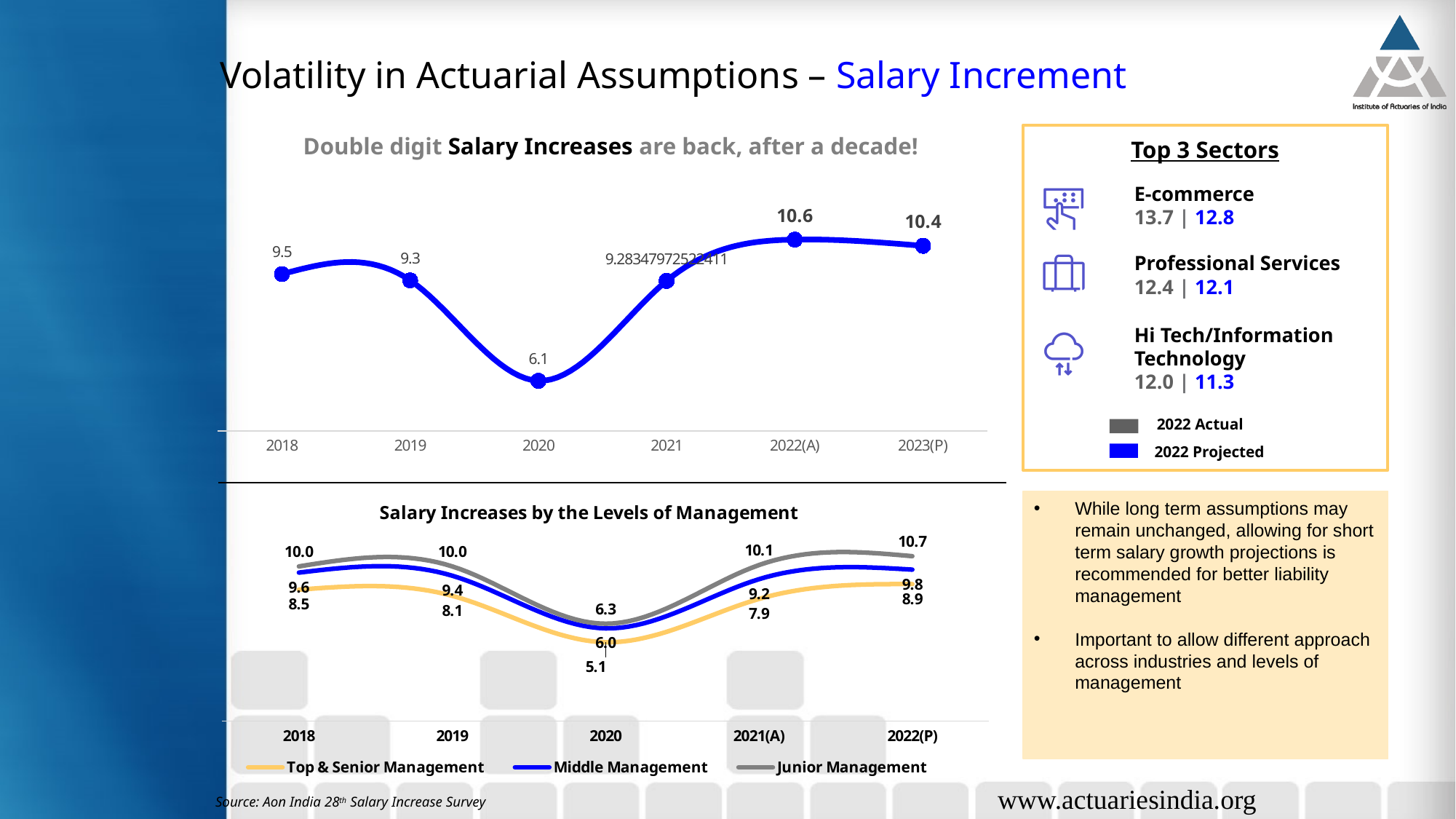
In the top line chart, which year has the lowest value? 2020 In the chart 'Salary Increases by the Levels of Management', how many series does the legend list? 3 In the top line chart, which year has the highest value? 2022(A) In the top line chart, what is the value for 2020? 6.1 In the top line chart, what is the value for 2022(A)? 10.6 In the chart 'Salary Increases by the Levels of Management', which is larger in 2021(A): Middle Management or Top & Senior Management? Middle Management In the chart 'Salary Increases by the Levels of Management', what is the difference between Junior Management and Top & Senior Management in 2018? 1.5 In the chart 'Salary Increases by the Levels of Management', what is the value for Junior Management in 2022(P)? 10.7 In the top line chart, how many years are shown on the x axis? 6 In the top line chart, what is the difference between the 2022(A) value and the 2023(P) value? 0.2 What type of chart is 'Salary Increases by the Levels of Management'? Line chart In the chart 'Salary Increases by the Levels of Management', what is the value for Top & Senior Management in 2020? 5.1